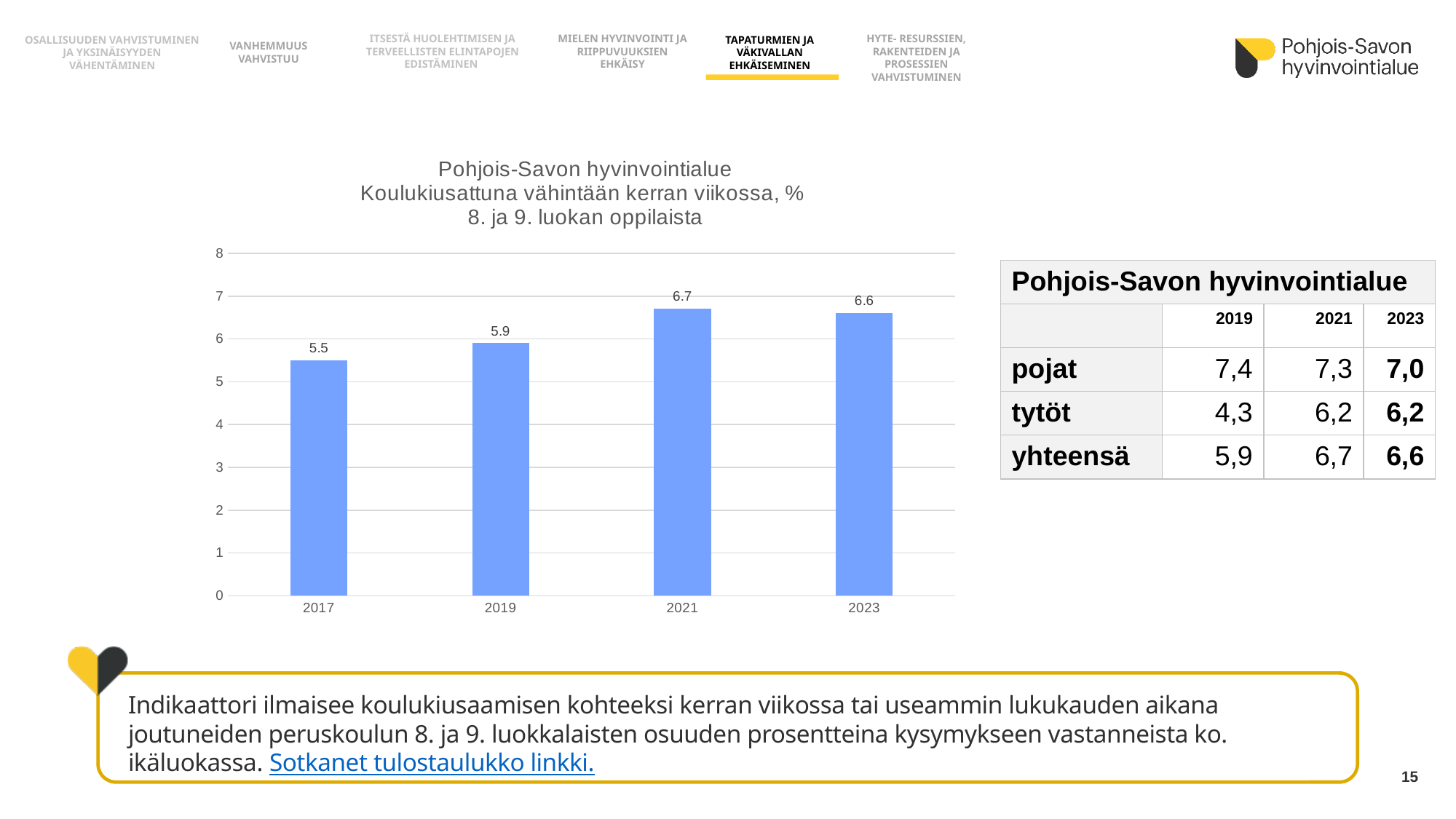
What is the difference between the values for 2021 and 2017? 1.2 Which year has the lowest value? 2017 What is the value for 2017? 5.5 Is the value for 2019 greater or less than 6? less What is the value for 2023? 6.6 Which is larger, the value for 2019 or the value for 2023? 2023 Which year has the highest value? 2021 What is the value for 2021? 6.7 What is the third line of the chart title? 8. ja 9. luokan oppilaista What kind of chart is shown? bar chart How many years are shown on the x axis? 4 Do the values rise or fall from 2017 to 2021? rise